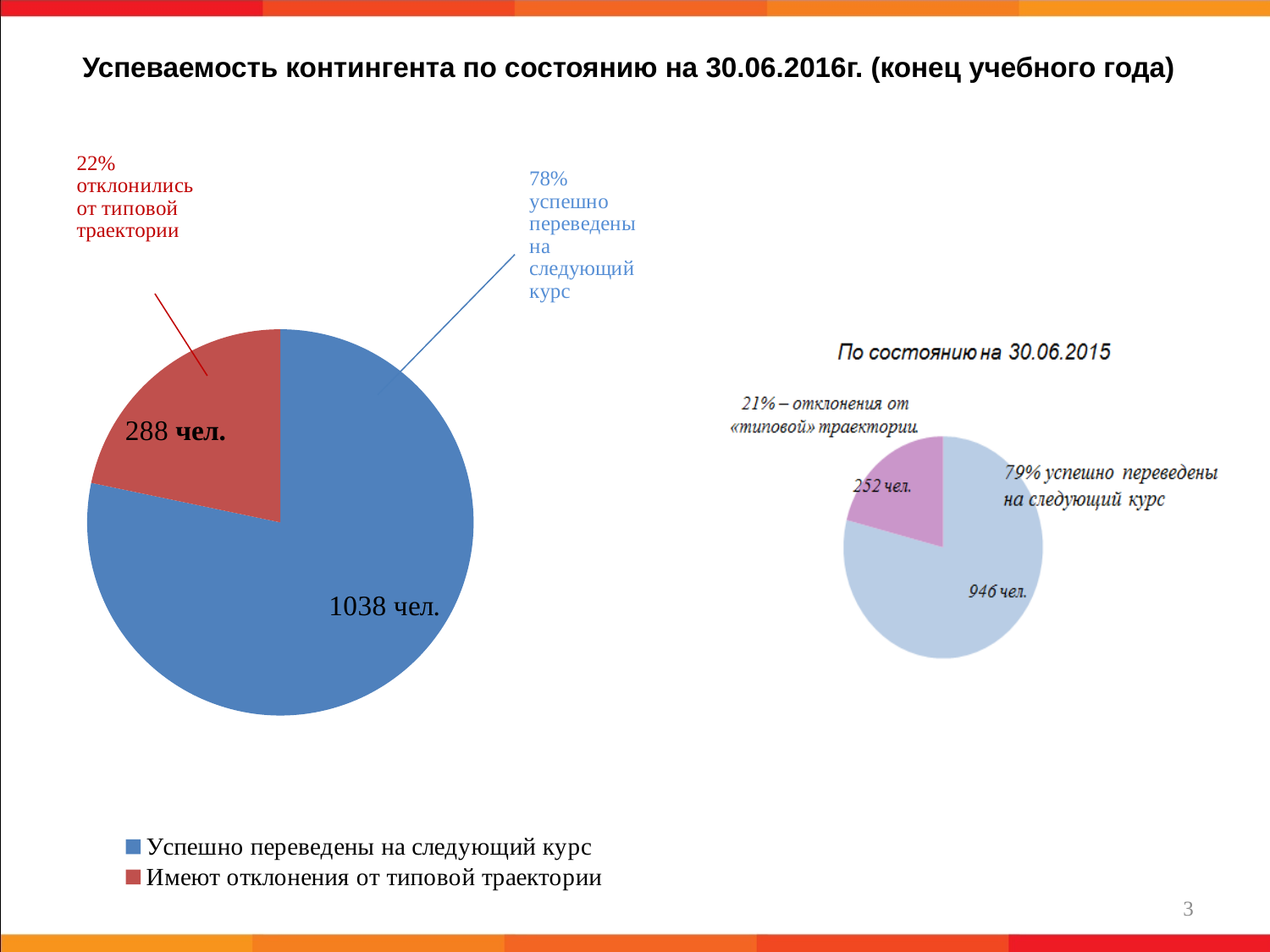
On the large pie chart on the left, what share of the pie is labelled as deviated from the typical trajectory? 22% What type of chart is the large chart on the left? Pie chart On the large pie chart on the left, what is the total number of people across both slices? 1326 On the small pie chart on the right titled 'По состоянию на 30.06.2015', what percentage is labelled as deviations from the typical trajectory? 21% On the large pie chart on the left, what is the difference between the number successfully transferred and the number with deviations? 750 On the large pie chart on the left, how many people have deviations from the typical trajectory (Имеют отклонения от типовой траектории)? 288 чел. How many entries does the legend at the bottom of the slide list? 2 On the large pie chart on the left, how many people were successfully transferred to the next course (Успешно переведены на следующий курс)? 1038 чел. On the small pie chart on the right titled 'По состоянию на 30.06.2015', how many people had deviations from the typical trajectory? 252 чел. On the large pie chart on the left, which slice is larger: successfully transferred or deviated from the typical trajectory? Successfully transferred (Успешно переведены на следующий курс) On the small pie chart on the right titled 'По состоянию на 30.06.2015', how many people were successfully transferred to the next course? 946 чел. On the large pie chart on the left, what share of the pie is labelled as successfully transferred to the next course? 78%